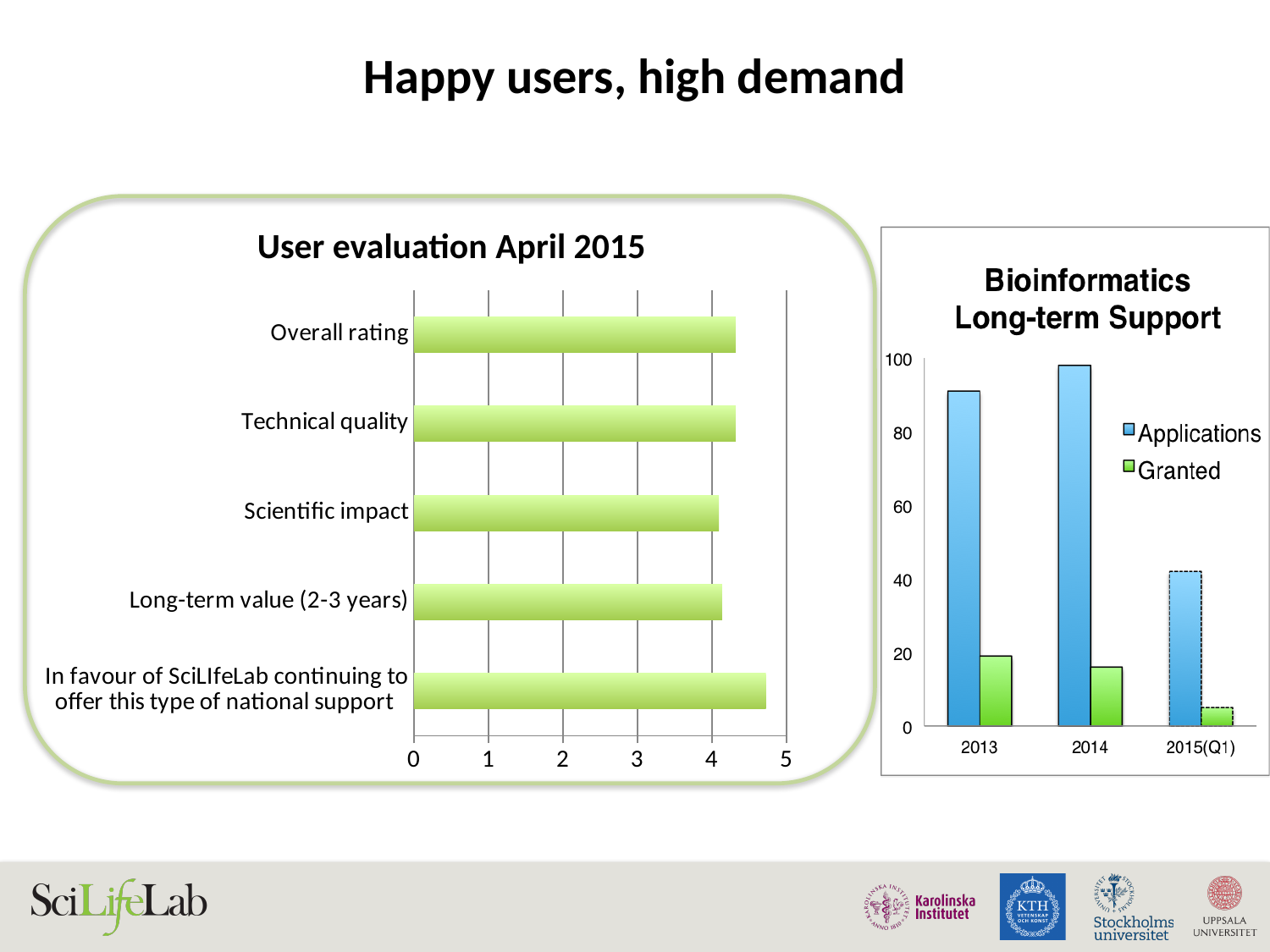
How many categories are shown in the User evaluation April 2015 chart? 5 What kind of chart is the User evaluation April 2015 chart? bar chart In the Bioinformatics Long-term Support chart, which year has the lowest number of Applications? 2015(Q1) In the Bioinformatics Long-term Support chart, which year has the highest number of Applications? 2014 How many series does the legend of the Bioinformatics Long-term Support chart list? 2 In the User evaluation April 2015 chart, which category has the highest value? In favour of SciLIfeLab continuing to offer this type of national support In the Bioinformatics Long-term Support chart, is the Granted value for 2014 greater or less than 20? less In the User evaluation April 2015 chart, is the value for Scientific impact greater or less than 5? less In the User evaluation April 2015 chart, is the value for Overall rating greater or less than 4? greater In the Bioinformatics Long-term Support chart, which is larger in 2014: Applications or Granted? Applications